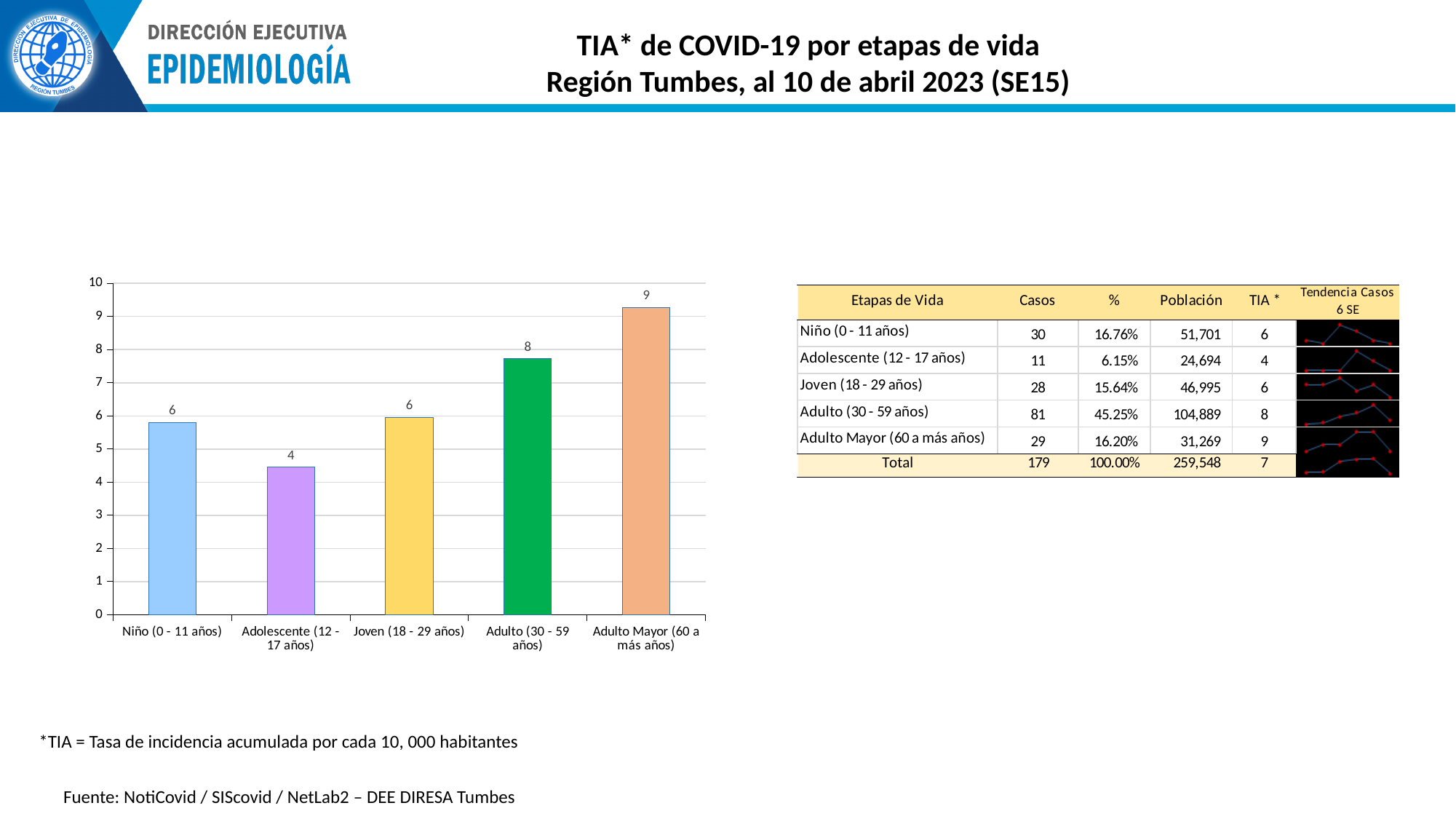
Which life stage has the lowest TIA in the bar chart? Adolescente (12 - 17 años) Which life stage has the highest TIA in the bar chart? Adulto Mayor (60 a más años) What is the TIA value shown for Adulto Mayor (60 a más años) in the bar chart? 9 What is the TIA value shown for Adolescente (12 - 17 años) in the bar chart? 4 What type of chart is used to show TIA by life stage on this slide? Bar chart What colour is the bar for Adulto (30 - 59 años) in the bar chart? Green In the bar chart, which has a higher TIA: Adulto (30 - 59 años) or Joven (18 - 29 años)? Adulto (30 - 59 años) What is the TIA value shown for Adulto (30 - 59 años) in the bar chart? 8 What is the difference between the TIA labels for Adulto Mayor (60 a más años) and Adolescente (12 - 17 años) in the bar chart? 5 How many life-stage categories are plotted in the bar chart? 5